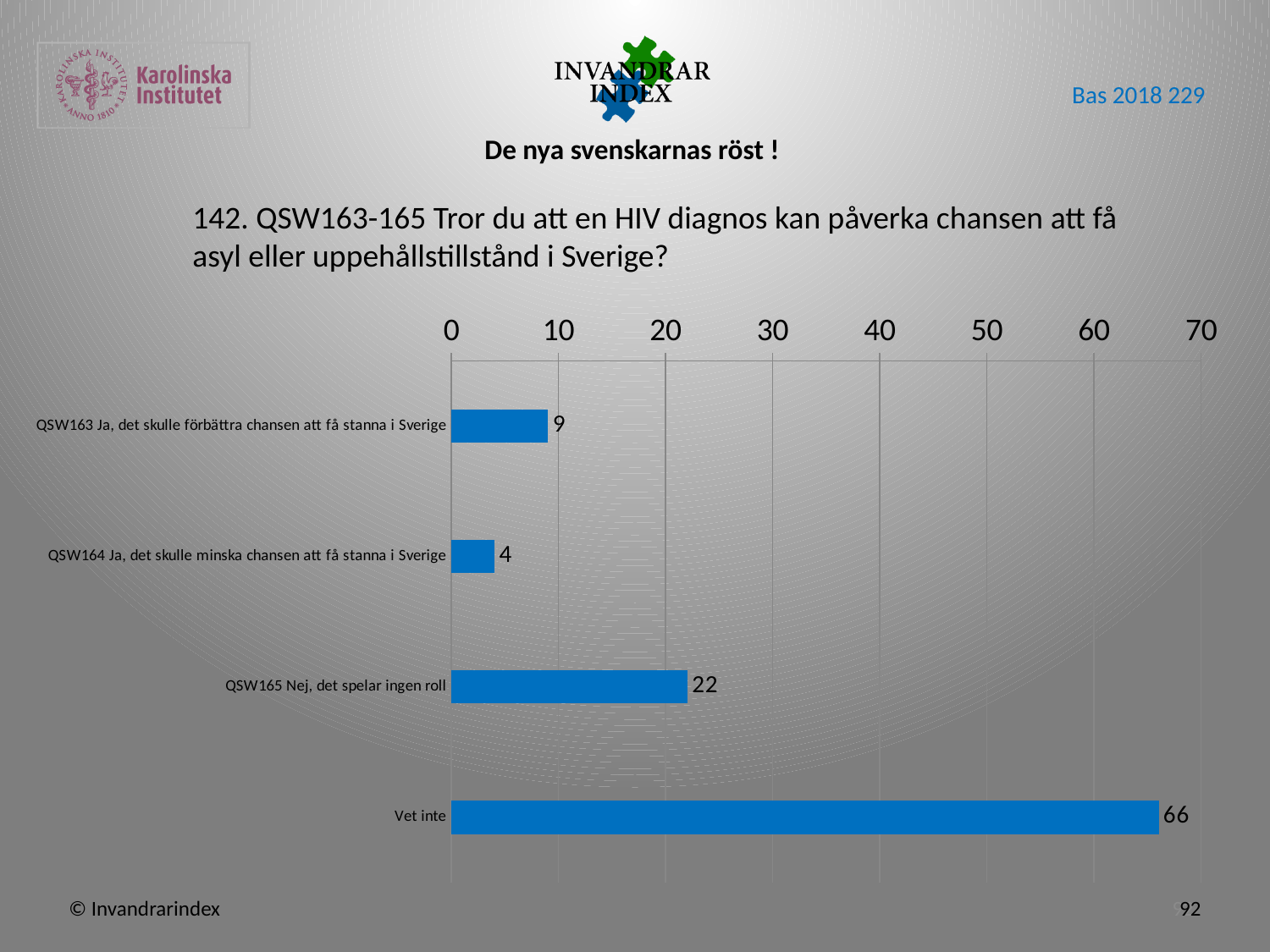
What is the difference between the values for "Vet inte" and "QSW165 Nej, det spelar ingen roll"? 44 Which category has the highest value? Vet inte What is the value for "QSW164 Ja, det skulle minska chansen att få stanna i Sverige"? 4 How many categories are shown in the chart? 4 Which is larger, the value for QSW163 or the value for QSW165? QSW165 Is the value for "Vet inte" greater or less than 60? greater What is the value for "QSW163 Ja, det skulle förbättra chansen att få stanna i Sverige"? 9 What is the value for "QSW165 Nej, det spelar ingen roll"? 22 What kind of chart is shown on the slide? bar chart Which category has the lowest value? QSW164 Ja, det skulle minska chansen att få stanna i Sverige What is the value for "Vet inte"? 66 What is the difference between the values for QSW163 and QSW164? 5